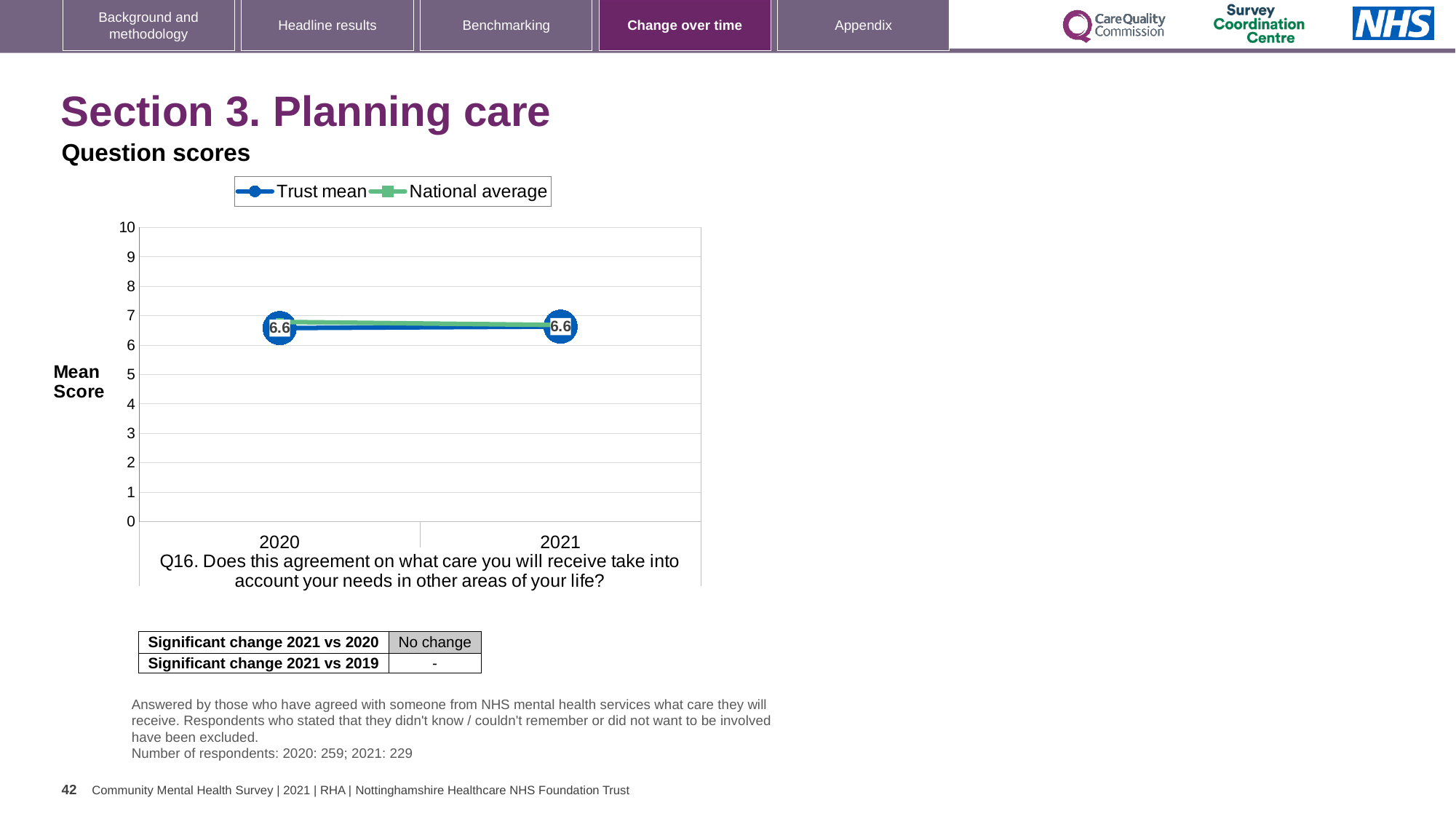
What is the difference between the Trust mean scores for 2021 and 2020? 0 What is the label on the y axis of the chart? Mean Score Does the Trust mean rise, fall, or stay the same from 2020 to 2021? stays the same Is the National average value for 2021 greater or less than 8? less What are the two series named in the chart legend? Trust mean and National average How many years are plotted on the x axis of the chart? 2 What kind of chart is shown on the slide? line chart Is the Trust mean score for 2021 larger than, smaller than, or equal to the Trust mean score for 2020? equal What is the Trust mean score for 2021? 6.6 What is the Trust mean score for 2020? 6.6 How many series does the chart legend list? 2 Is the National average value for 2020 greater or less than 5? greater